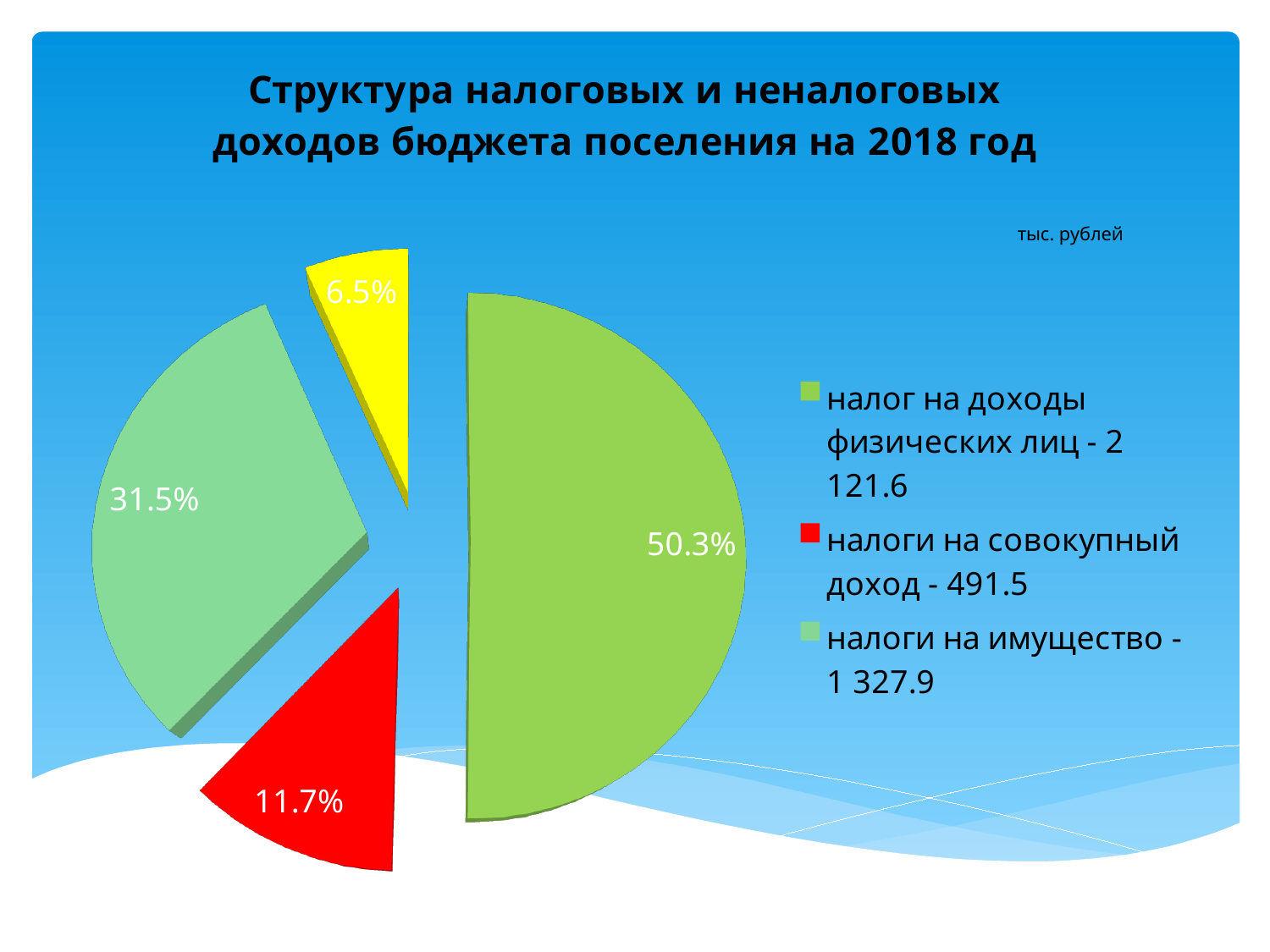
By how many percentage points does the share of "налог на доходы физических лиц" exceed the share of "налоги на имущество"? 18.8% Which category has the largest slice of the pie? налог на доходы физических лиц What value does the legend give for "налоги на совокупный доход"? 491.5 What share of the pie does "налог на доходы физических лиц" take? 50.3% What value does the legend give for "налог на доходы физических лиц"? 2 121.6 What kind of chart is shown on the slide? pie chart What share of the pie does "налоги на имущество" take? 31.5% Which is larger: the slice for "налоги на имущество" or the slice for "налоги на совокупный доход"? налоги на имущество What unit is indicated above the chart? тыс. рублей What value does the legend give for "налоги на имущество"? 1 327.9 What share of the pie does "налоги на совокупный доход" take? 11.7% How many slices does the pie chart have? 4